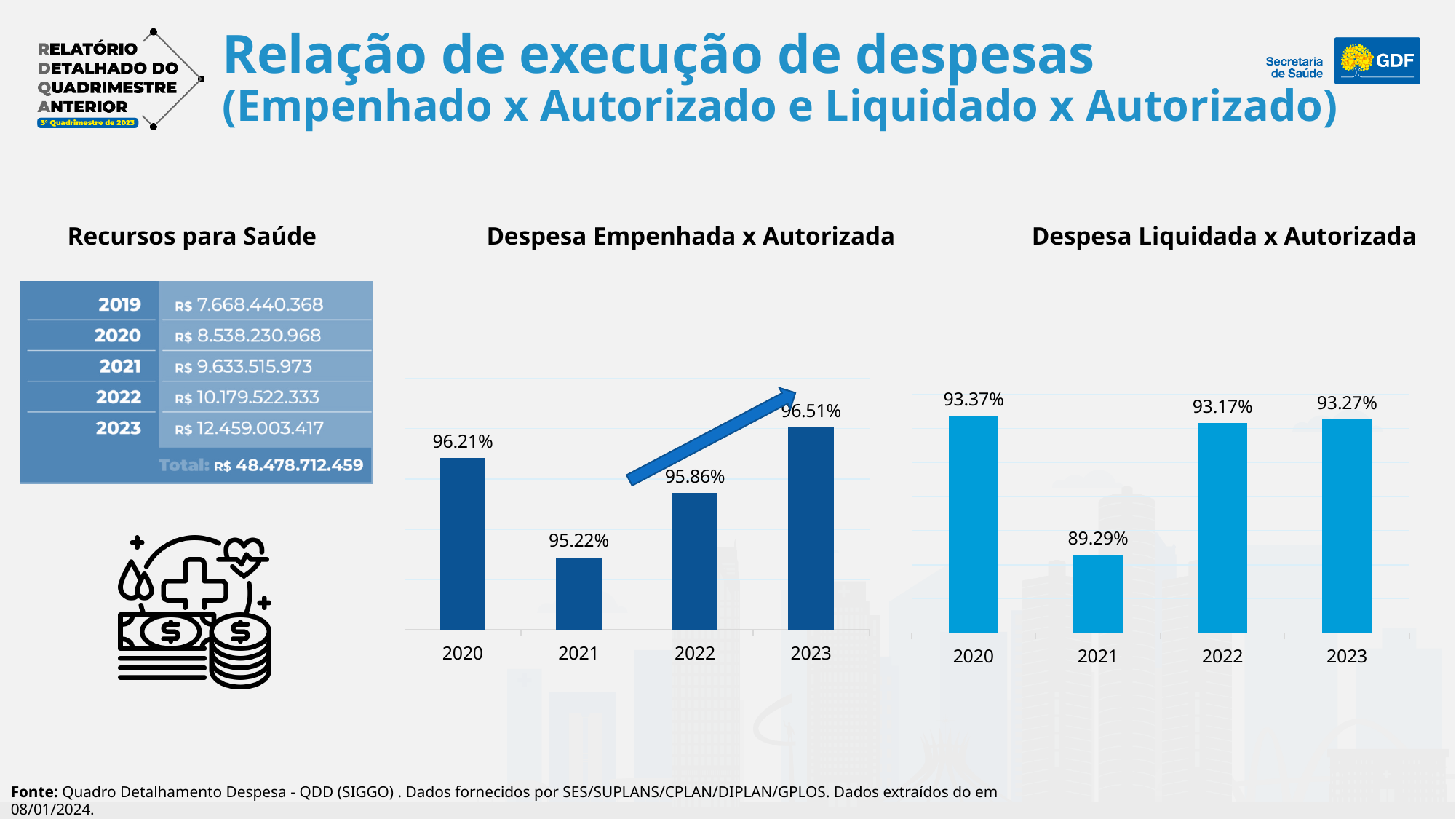
How many years are shown in the 'Despesa Liquidada x Autorizada' chart? 4 In the 'Despesa Empenhada x Autorizada' chart, which year has the highest value? 2023 In the 'Despesa Empenhada x Autorizada' chart, which year has the lowest value? 2021 In the 'Despesa Empenhada x Autorizada' chart, what is the value for 2021? 95.22% In the 'Despesa Empenhada x Autorizada' chart, what is the difference between the 2023 and 2021 values? 1.29% In the 'Despesa Liquidada x Autorizada' chart, what is the value for 2021? 89.29% In the 'Despesa Liquidada x Autorizada' chart, what is the value for 2020? 93.37% In the 'Despesa Empenhada x Autorizada' chart, which is larger, the value for 2020 or the value for 2022? 2020 In the 'Despesa Liquidada x Autorizada' chart, which year has the lowest value? 2021 In the 'Despesa Empenhada x Autorizada' chart, what is the value for 2023? 96.51% In the 'Despesa Liquidada x Autorizada' chart, what is the difference between the 2020 and 2021 values? 4.08% In the 'Despesa Liquidada x Autorizada' chart, which year has the highest value? 2020